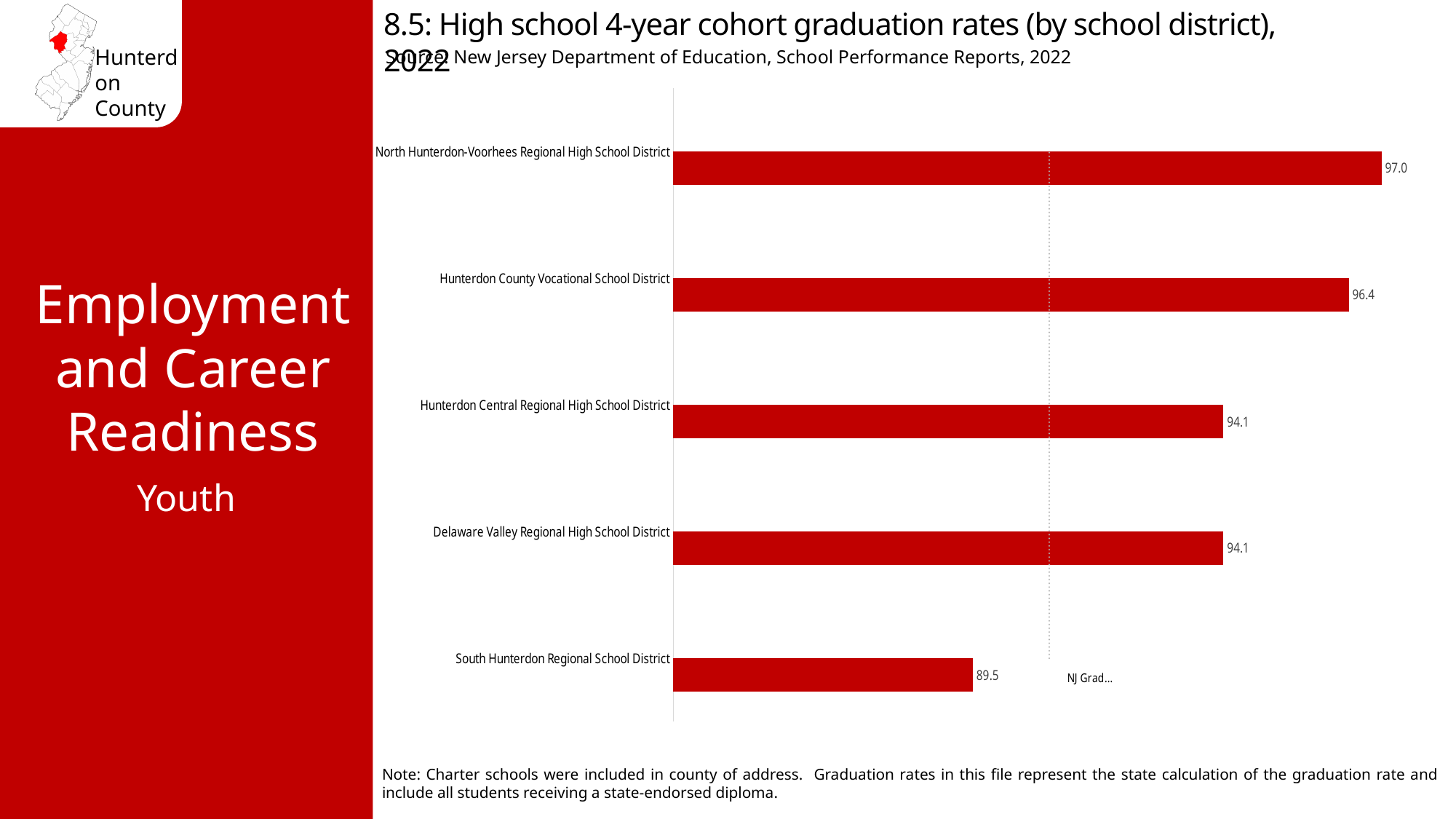
What is the graduation rate for South Hunterdon Regional School District? 89.5 Which two school districts have the same graduation rate of 94.1? Hunterdon Central Regional High School District and Delaware Valley Regional High School District What is the graduation rate for Hunterdon County Vocational School District? 96.4 What is the graduation rate for Delaware Valley Regional High School District? 94.1 Which school district has the highest graduation rate? North Hunterdon-Voorhees Regional High School District What type of chart is used to show the graduation rates? Bar chart What is the difference between the graduation rates of North Hunterdon-Voorhees Regional High School District and South Hunterdon Regional School District? 7.5 What is the graduation rate for North Hunterdon-Voorhees Regional High School District? 97.0 Which has a higher graduation rate, Hunterdon County Vocational School District or Delaware Valley Regional High School District? Hunterdon County Vocational School District Which school district has the lowest graduation rate? South Hunterdon Regional School District What is the difference between the graduation rates of Hunterdon County Vocational School District and Hunterdon Central Regional High School District? 2.3 How many school districts are shown in the chart? 5